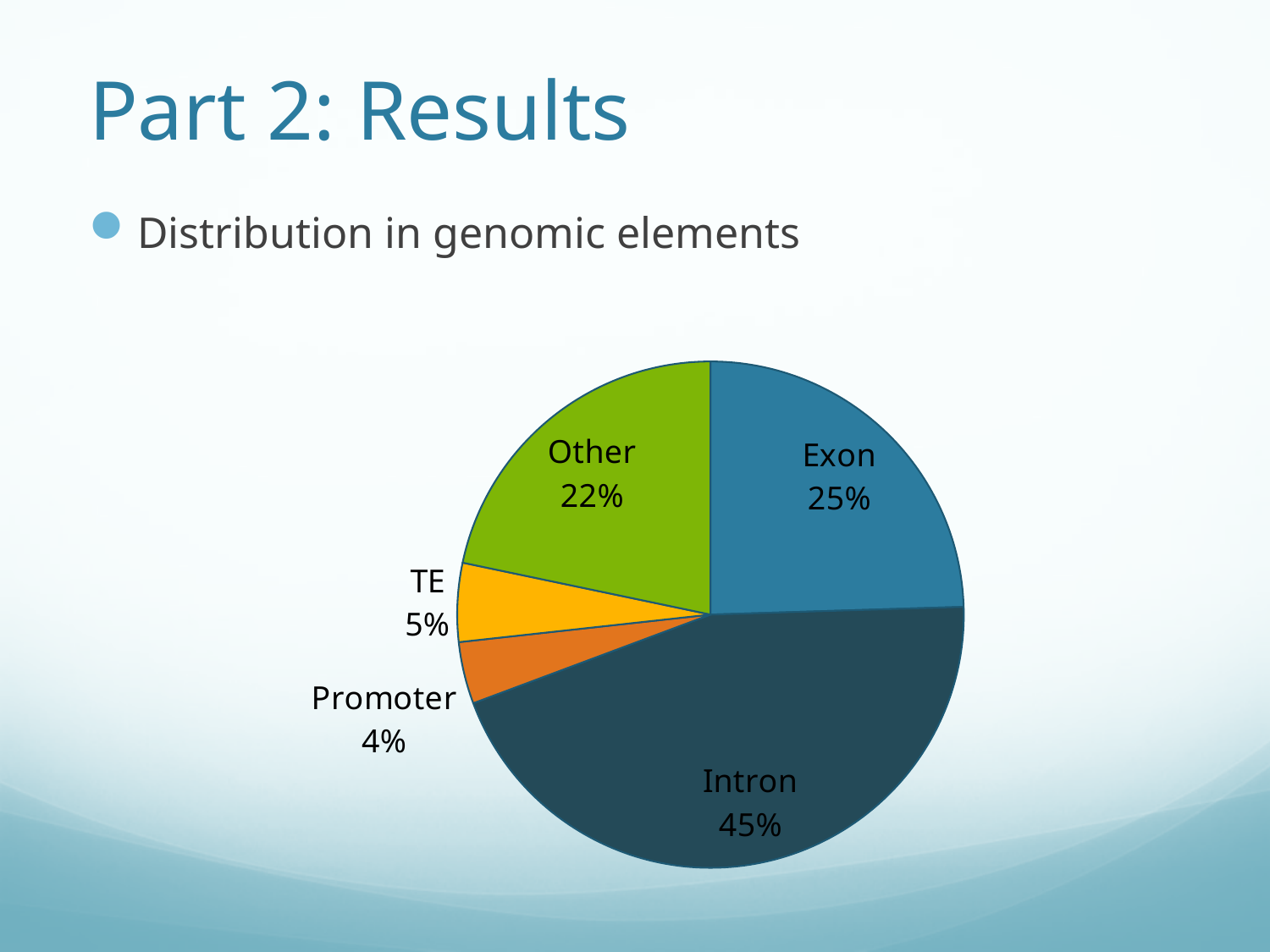
What kind of chart is shown on the slide? pie chart What percentage of the pie does Intron account for? 45% Which is larger, the Other slice or the Exon slice? Exon What is the value shown for Exon? 25% What colour is the Other slice? green What is the combined share of TE and Promoter? 9% How many slices does the pie chart have? 5 What is the value shown for TE? 5% What is the difference between the Intron and Exon percentages? 20% Which genomic element has the largest slice of the pie? Intron What is the value shown for Promoter? 4% Which genomic element has the smallest slice of the pie? Promoter